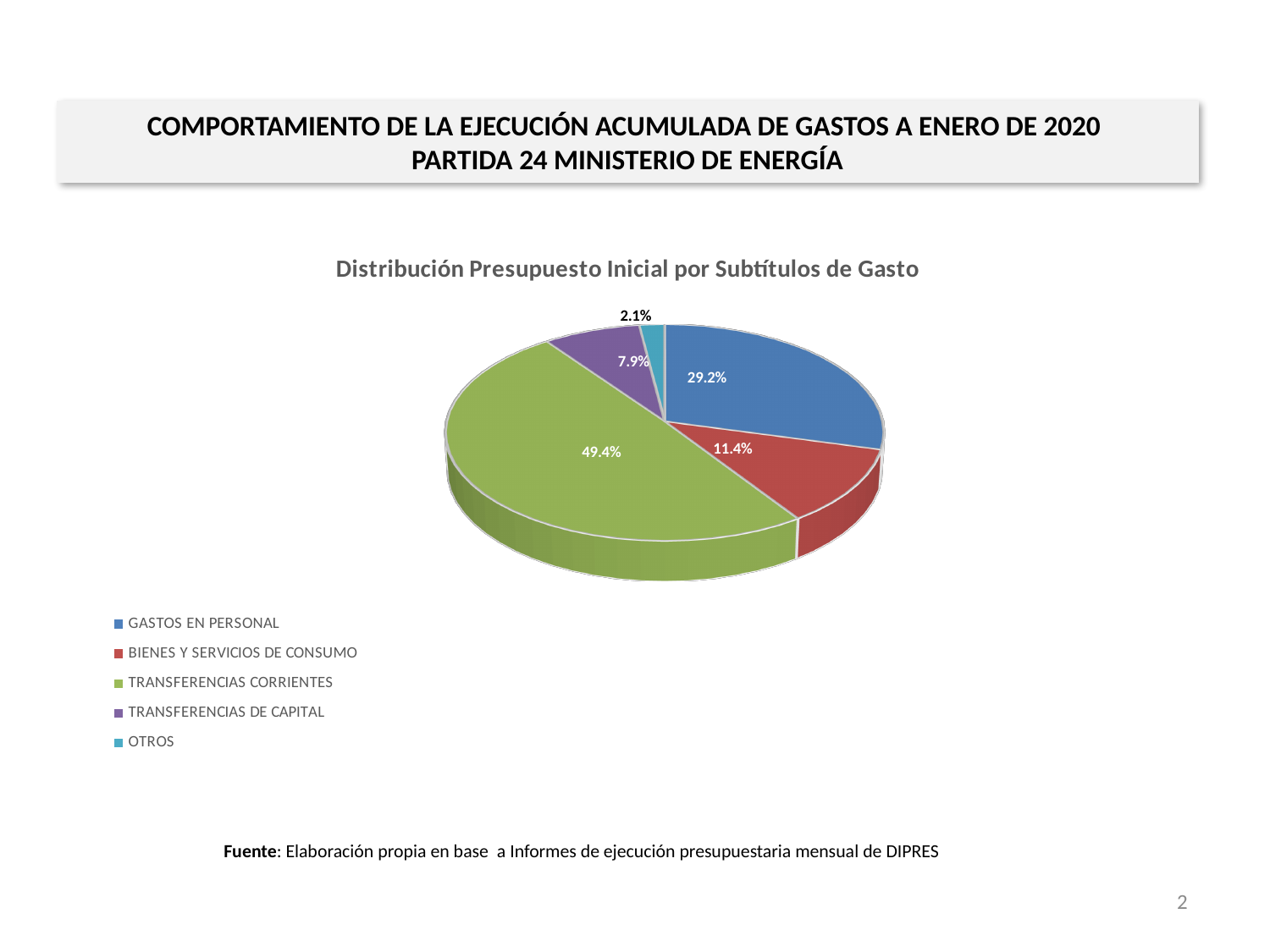
What share of the pie does TRANSFERENCIAS CORRIENTES represent? 49.4% Which is larger, the share for GASTOS EN PERSONAL or for BIENES Y SERVICIOS DE CONSUMO? GASTOS EN PERSONAL What is the title of the chart? Distribución Presupuesto Inicial por Subtítulos de Gasto What is the value shown for GASTOS EN PERSONAL? 29.2% What is the value shown for BIENES Y SERVICIOS DE CONSUMO? 11.4% What is the value shown for OTROS? 2.1% What is the value shown for TRANSFERENCIAS DE CAPITAL? 7.9% What is the difference between the shares of TRANSFERENCIAS CORRIENTES and GASTOS EN PERSONAL? 20.2% Which category has the largest slice of the pie? TRANSFERENCIAS CORRIENTES What kind of chart is shown on the slide? Pie chart Which category has the smallest slice of the pie? OTROS How many categories does the pie chart show? 5